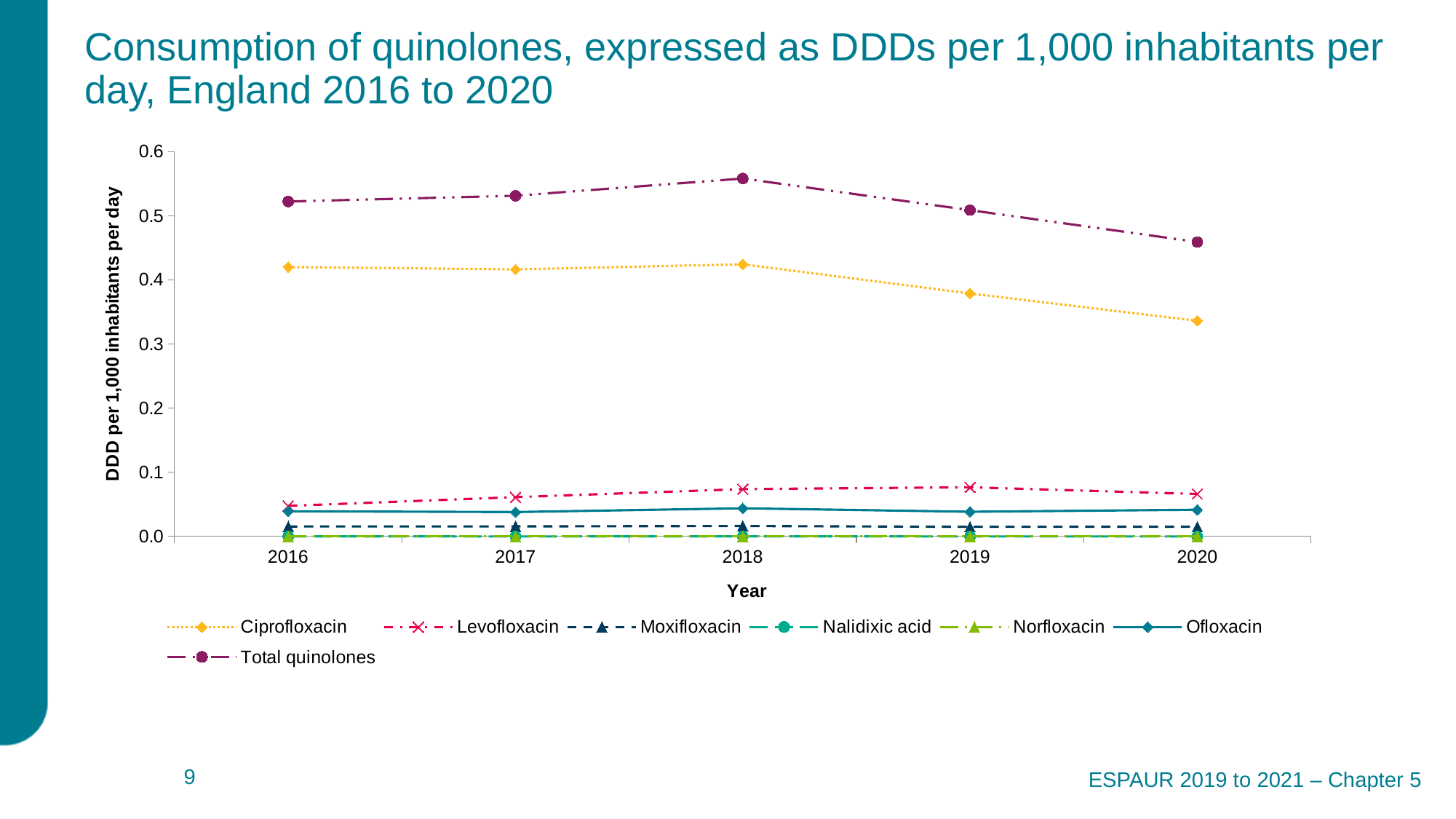
Is the Total quinolones value for 2018 greater or less than 0.5? greater Does the Total quinolones line rise or fall from 2018 to 2020? fall Is the Levofloxacin value for 2019 greater or less than 0.1? less In which year is the Ciprofloxacin value lowest? 2020 What is the title of the x axis? Year In which year is the Total quinolones value lowest? 2020 How many series does the legend list? 7 In 2018, which is larger: the Ciprofloxacin value or the Levofloxacin value? Ciprofloxacin How many years are plotted along the x axis? 5 Is the Ciprofloxacin value for 2020 greater or less than 0.3? greater In which year is the Total quinolones value highest? 2018 What kind of chart is shown on the slide? line chart